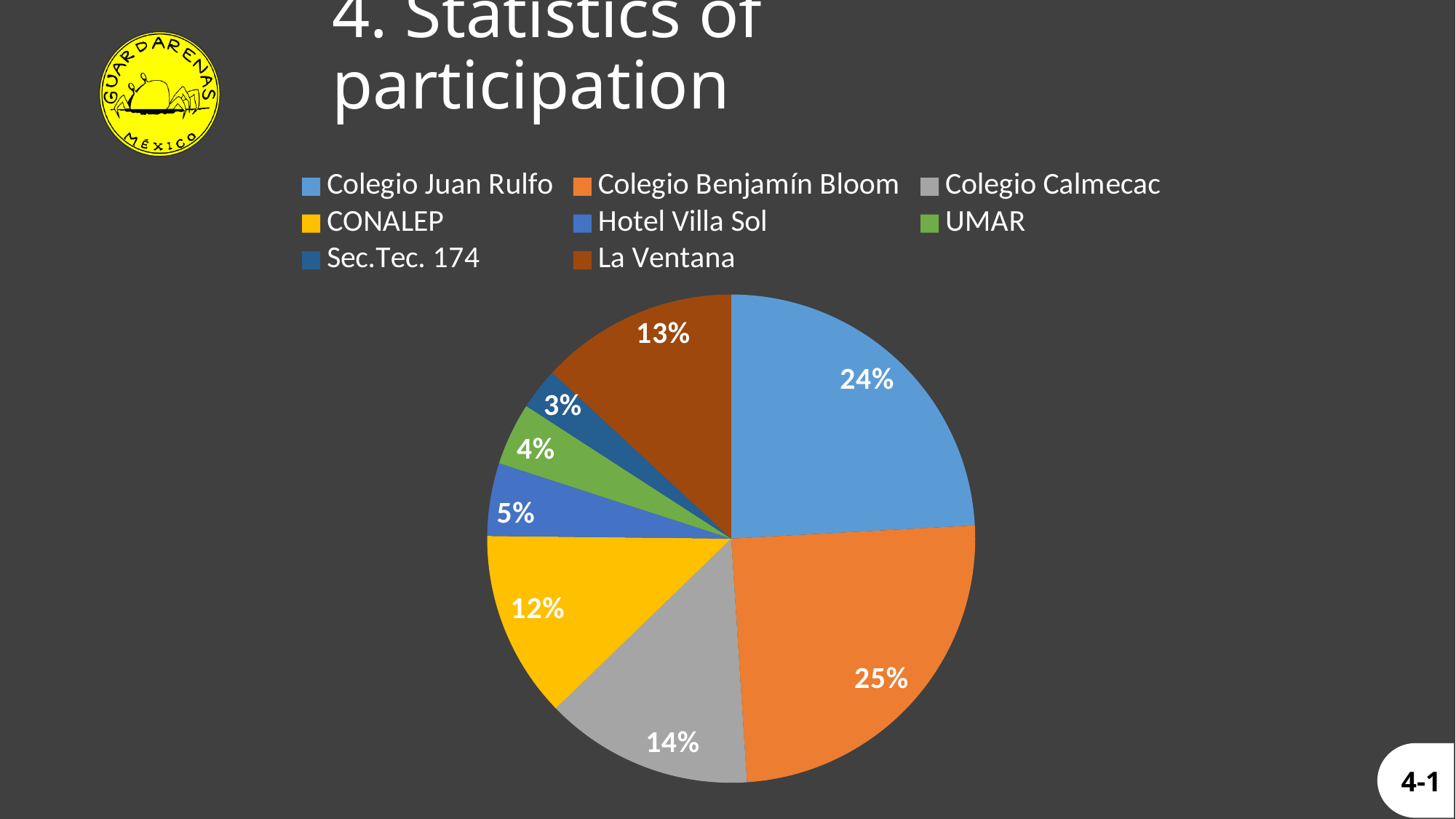
Which category has the smallest share of the pie? Sec.Tec. 174 Which category has the largest share of the pie? Colegio Benjamín Bloom What is the difference between the shares of Colegio Calmecac and CONALEP? 2% What share of participation does Sec.Tec. 174 have? 3% What share of participation does Colegio Juan Rulfo have? 24% What type of chart is shown on the slide? pie chart What share of participation does La Ventana have? 13% Which has a larger share, Hotel Villa Sol or UMAR? Hotel Villa Sol How many categories does the legend list? 8